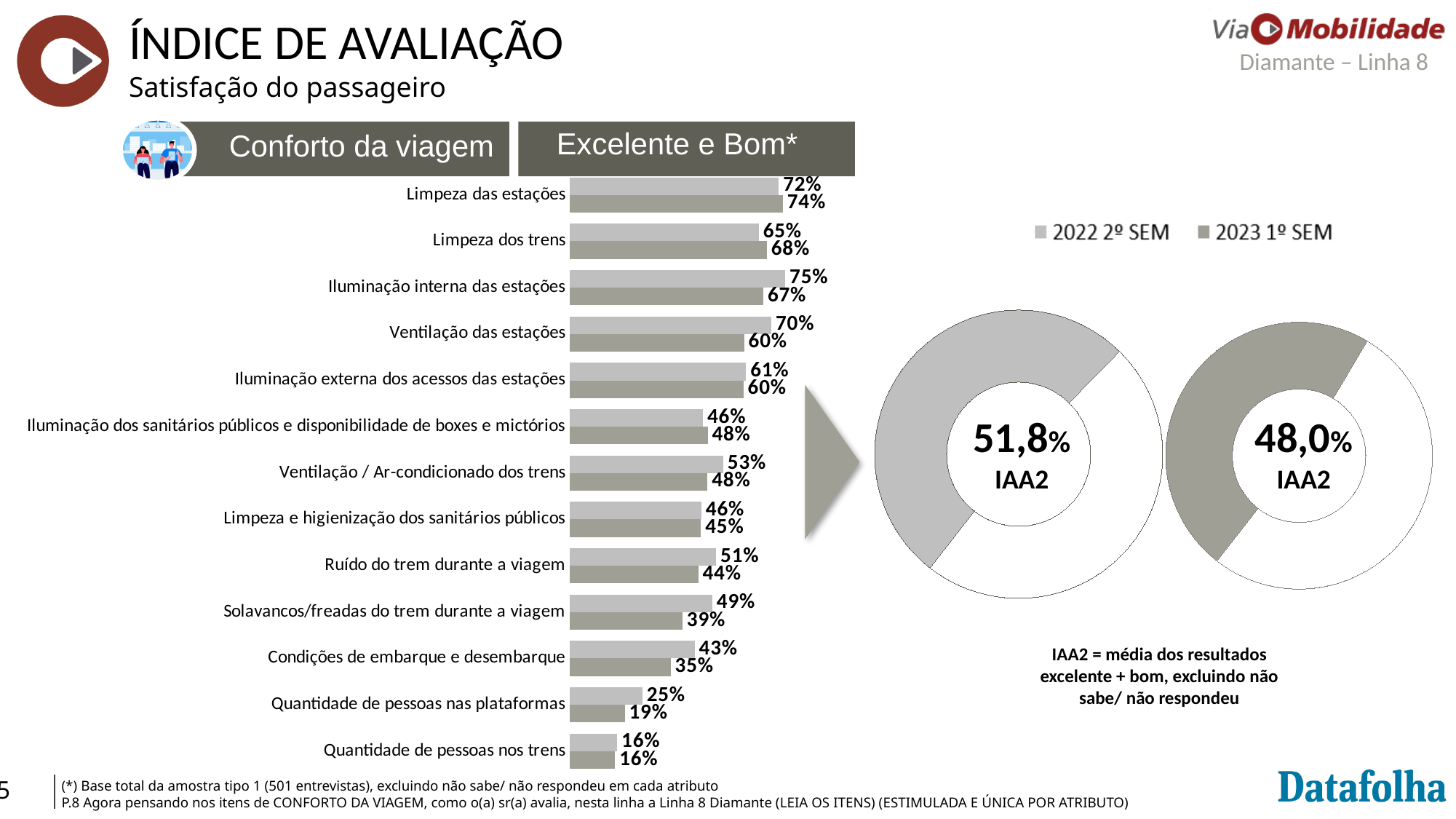
What IAA2 value is shown in the right donut chart (2023 1º SEM)? 48,0% In the bar chart, what is the difference between the 2022 2º SEM and 2023 1º SEM values for Solavancos/freadas do trem durante a viagem? 10% In the bar chart, what is the 2022 2º SEM value for Ventilação das estações? 70% What kind of chart is used to show the Conforto da viagem attributes? Bar chart In the bar chart, which category has the highest 2022 2º SEM value? Iluminação interna das estações In the bar chart, which is larger for Limpeza dos trens: the 2022 2º SEM value or the 2023 1º SEM value? 2023 1º SEM How many categories does the bar chart show? 13 In the bar chart, which category has the lowest 2023 1º SEM value? Quantidade de pessoas nos trens In the bar chart, what is the 2023 1º SEM value for Quantidade de pessoas nas plataformas? 19% In the bar chart, what is the 2023 1º SEM value for Limpeza das estações? 74% How many series does the legend of the bar chart list? 2 What IAA2 value is shown in the left donut chart (2022 2º SEM)? 51,8%